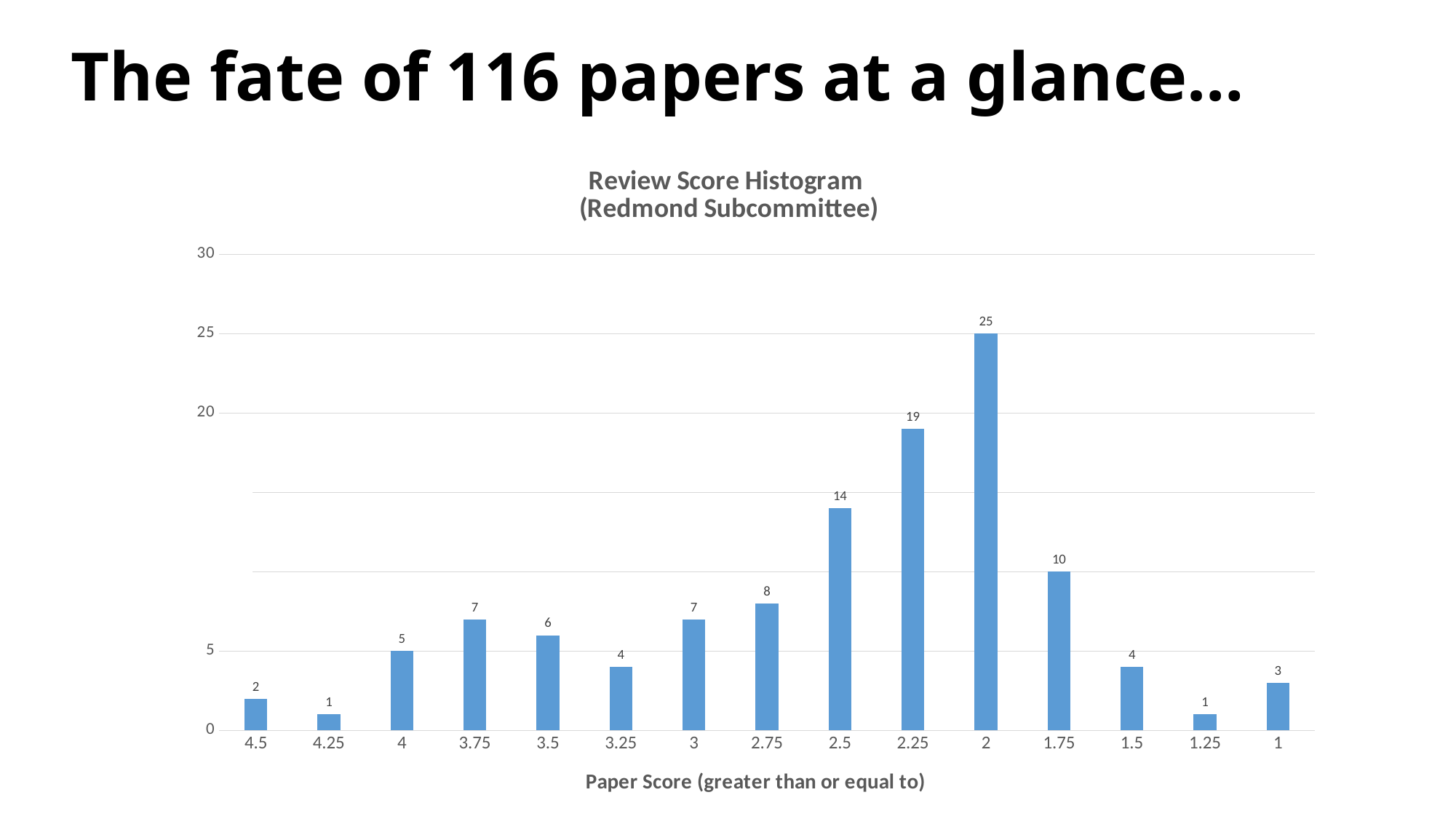
What is the difference between the values for paper scores 2 and 2.25? 6 Is the value for paper score 2.25 greater or less than 15? greater Which paper score has the highest value? 2 What is the difference between the values for paper scores 1.75 and 1.5? 6 What is the value for paper score 2? 25 What is the x-axis label of the chart? Paper Score (greater than or equal to) What is the title of the chart? Review Score Histogram (Redmond Subcommittee) How many paper score categories are shown on the x axis? 15 What kind of chart is shown on the slide? bar chart What is the value for paper score 3.75? 7 What is the value for paper score 2.5? 14 Which is larger, the value for paper score 1.75 or the value for paper score 2.75? 1.75